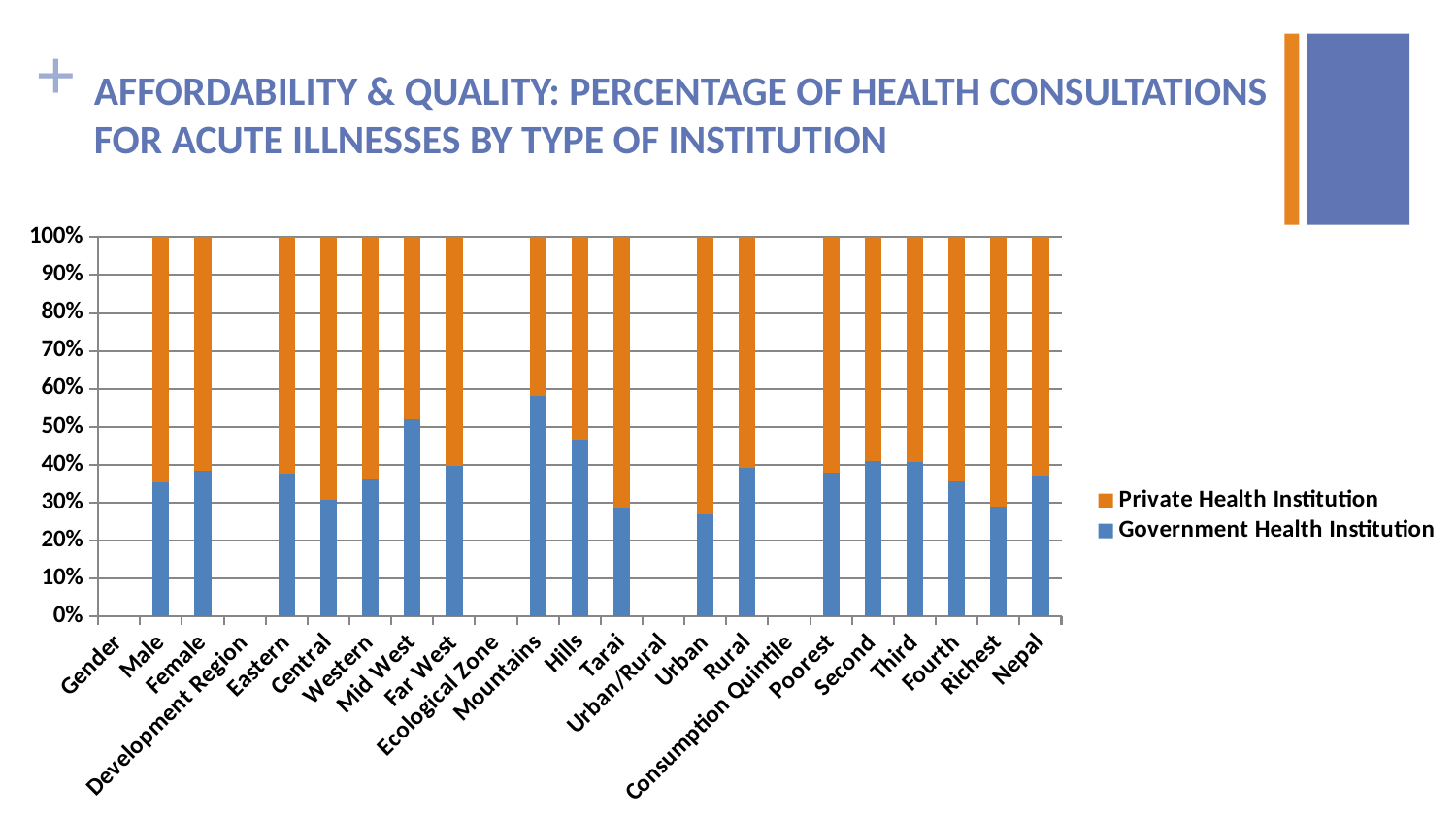
How many bars are plotted in the chart? 18 Is the Government Health Institution share for Urban greater or less than 30%? less Which has a larger Private Health Institution share, Tarai or Mountains? Tarai How many series does the legend list? 2 Which category has the highest share of Government Health Institution consultations? Mountains Is the Government Health Institution share for Hills greater or less than 40%? greater Is the Government Health Institution share for Central greater or less than 40%? less Which has a larger Government Health Institution share, Poorest or Richest? Poorest What kind of chart is shown on the slide? bar chart Which has a larger Government Health Institution share, Urban or Rural? Rural Which colour represents Private Health Institution in the legend? orange